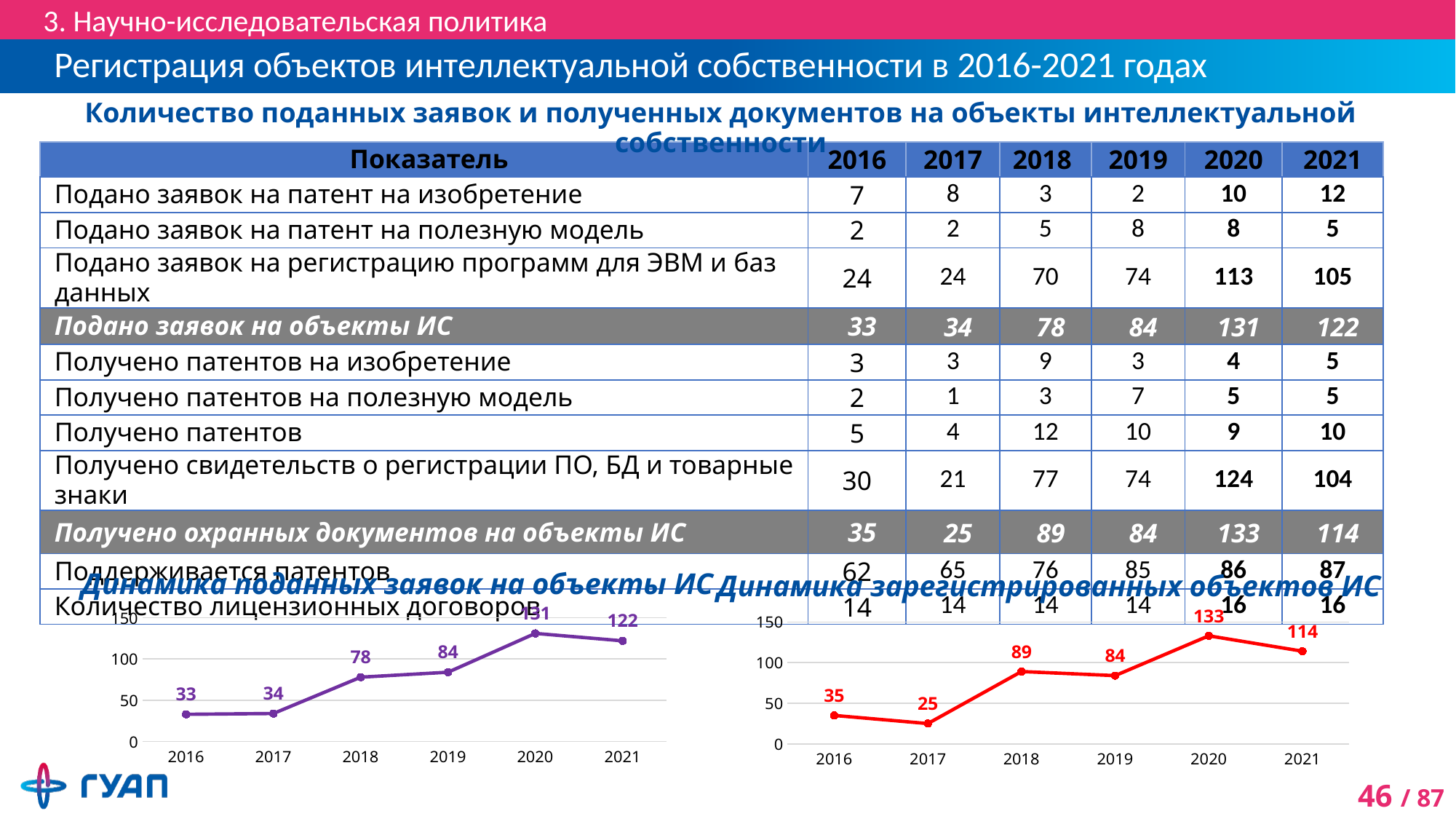
In the right chart 'Динамика зарегистрированных объектов ИС', which is larger, the value for 2018 or the value for 2019? 2018 In the right chart 'Динамика зарегистрированных объектов ИС', which year has the lowest value? 2017 In the left chart 'Динамика поданных заявок на объекты ИС', what is the value for 2018? 78 What kind of chart is the right chart 'Динамика зарегистрированных объектов ИС'? line chart In the left chart 'Динамика поданных заявок на объекты ИС', do the values rise or fall from 2016 to 2020? rise In the right chart 'Динамика зарегистрированных объектов ИС', what is the value for 2017? 25 How many years are plotted in the left chart 'Динамика поданных заявок на объекты ИС'? 6 In the left chart 'Динамика поданных заявок на объекты ИС', what is the value for 2021? 122 In the left chart 'Динамика поданных заявок на объекты ИС', what is the difference between the values for 2020 and 2021? 9 In the right chart 'Динамика зарегистрированных объектов ИС', what is the difference between the values for 2018 and 2017? 64 In the left chart 'Динамика поданных заявок на объекты ИС', which year has the highest value? 2020 In the right chart 'Динамика зарегистрированных объектов ИС', what is the value for 2020? 133